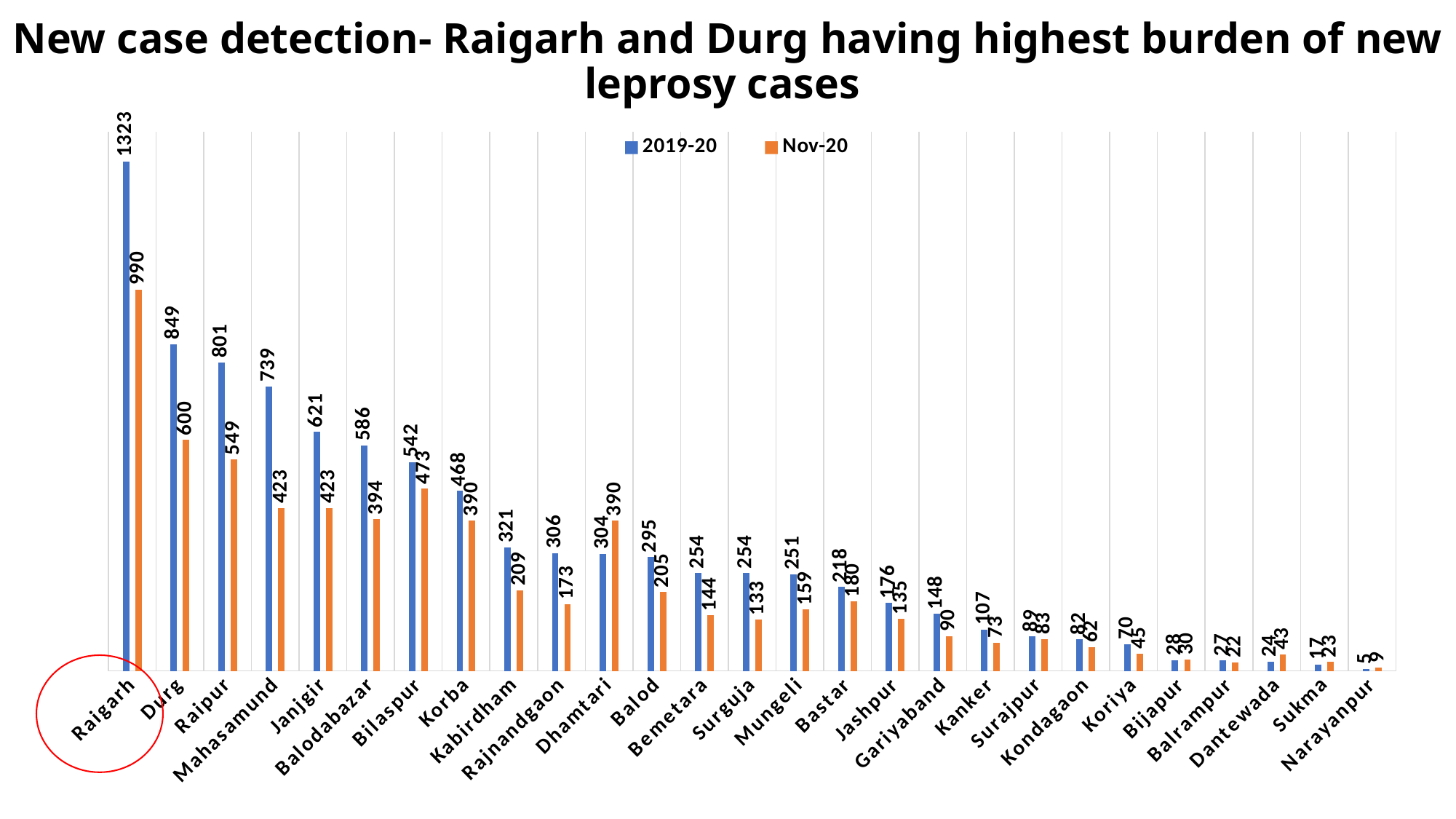
What is the Nov-20 value for Durg? 600 Which district has the highest 2019-20 value? Raigarh Do the 2019-20 values rise or fall moving from left to right along the x axis? Fall Which district has the lowest Nov-20 value? Narayanpur What is the difference between the 2019-20 and Nov-20 values for Raipur? 252 Which is larger: the 2019-20 value for Mahasamund or the 2019-20 value for Janjgir? Mahasamund What kind of chart is shown on the slide? Bar chart How many series does the legend list? 2 What is the Nov-20 value for Bilaspur? 473 For Dhamtari, which is larger: the 2019-20 value or the Nov-20 value? Nov-20 What is the 2019-20 value for Raigarh? 1323 How many districts are shown on the x axis? 27